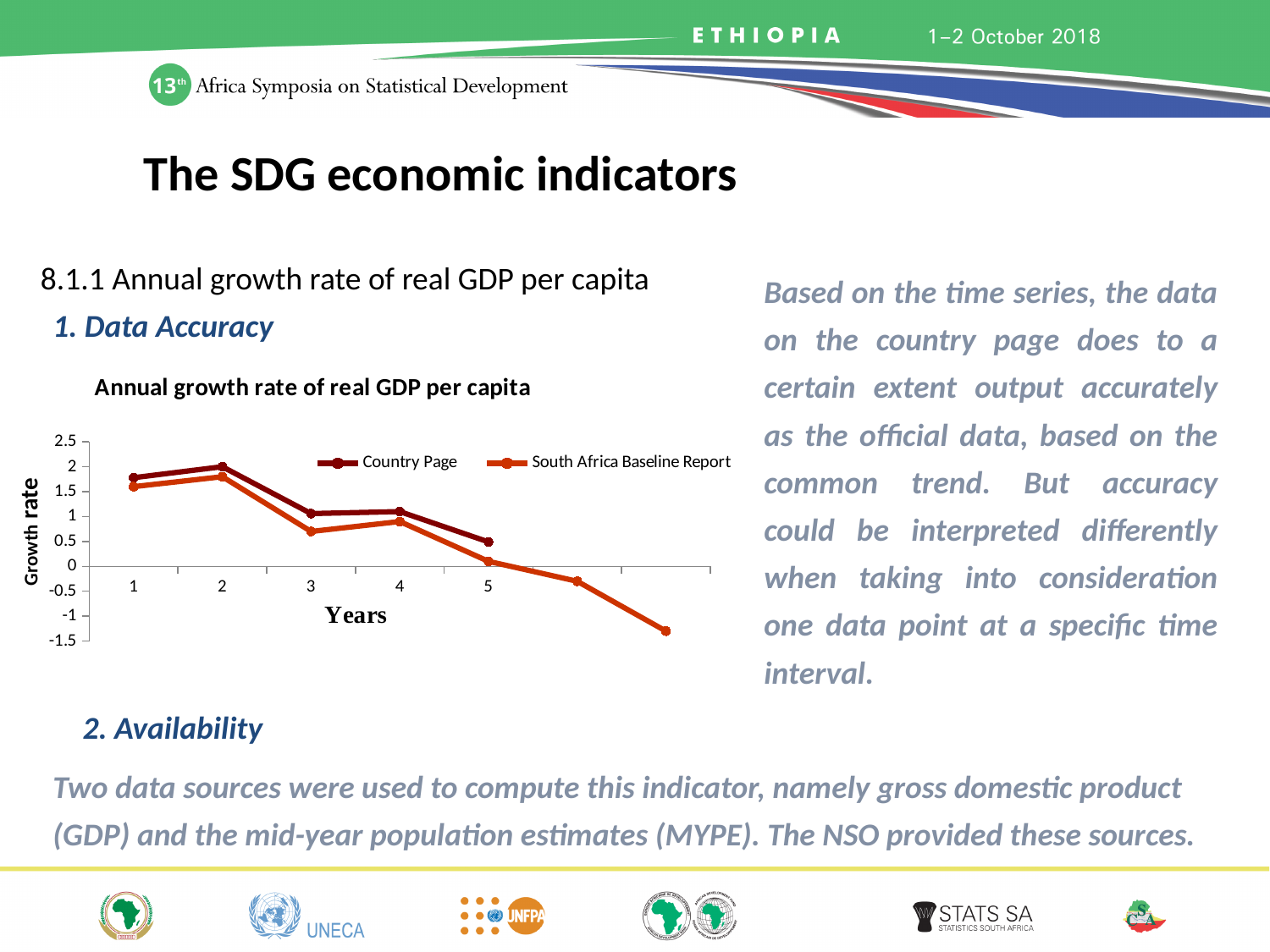
Is the Country Page value at year 2 greater or less than 1.5? greater What type of chart is shown on the slide? Line chart In which year does the South Africa Baseline Report series reach its highest value? 2 At year 3, which series has the larger value, Country Page or South Africa Baseline Report? Country Page Is the South Africa Baseline Report value at year 3 greater or less than 1? less What are the two series named in the chart legend? Country Page and South Africa Baseline Report What is the title of the chart? Annual growth rate of real GDP per capita Overall, do the values of the South Africa Baseline Report series rise or fall from year 2 onwards? fall How many data points are plotted for the Country Page series? 5 How many series does the legend of the chart list? 2 In which year does the Country Page series reach its highest value? 2 Is the Country Page value at year 5 greater or less than 1? less